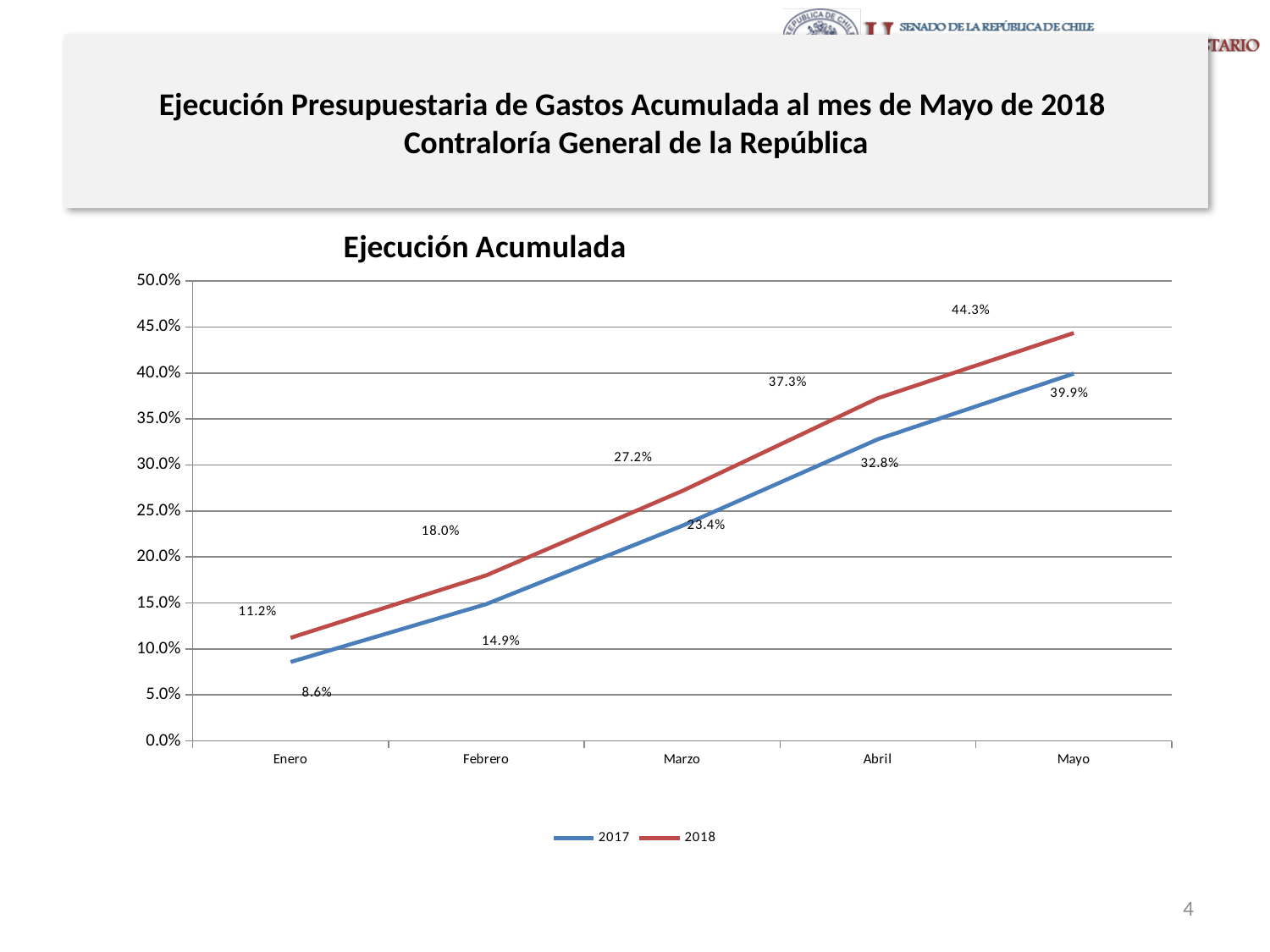
What is the value for 2017 in Enero? 8.6% How many series does the legend list? 2 What is the value for 2018 in Marzo? 27.2% In which month is the 2018 series at its lowest value? Enero Do the values of the 2018 series rise or fall from Enero to Mayo? Rise Which series has the higher value in Febrero, 2017 or 2018? 2018 What is the difference between the 2018 and 2017 values in Mayo? 4.4% What is the value for 2018 in Mayo? 44.3% What type of chart is shown on the slide? Line chart In which month does the 2017 series reach its highest value? Mayo What is the value for 2017 in Abril? 32.8% How many months are shown on the x axis? 5